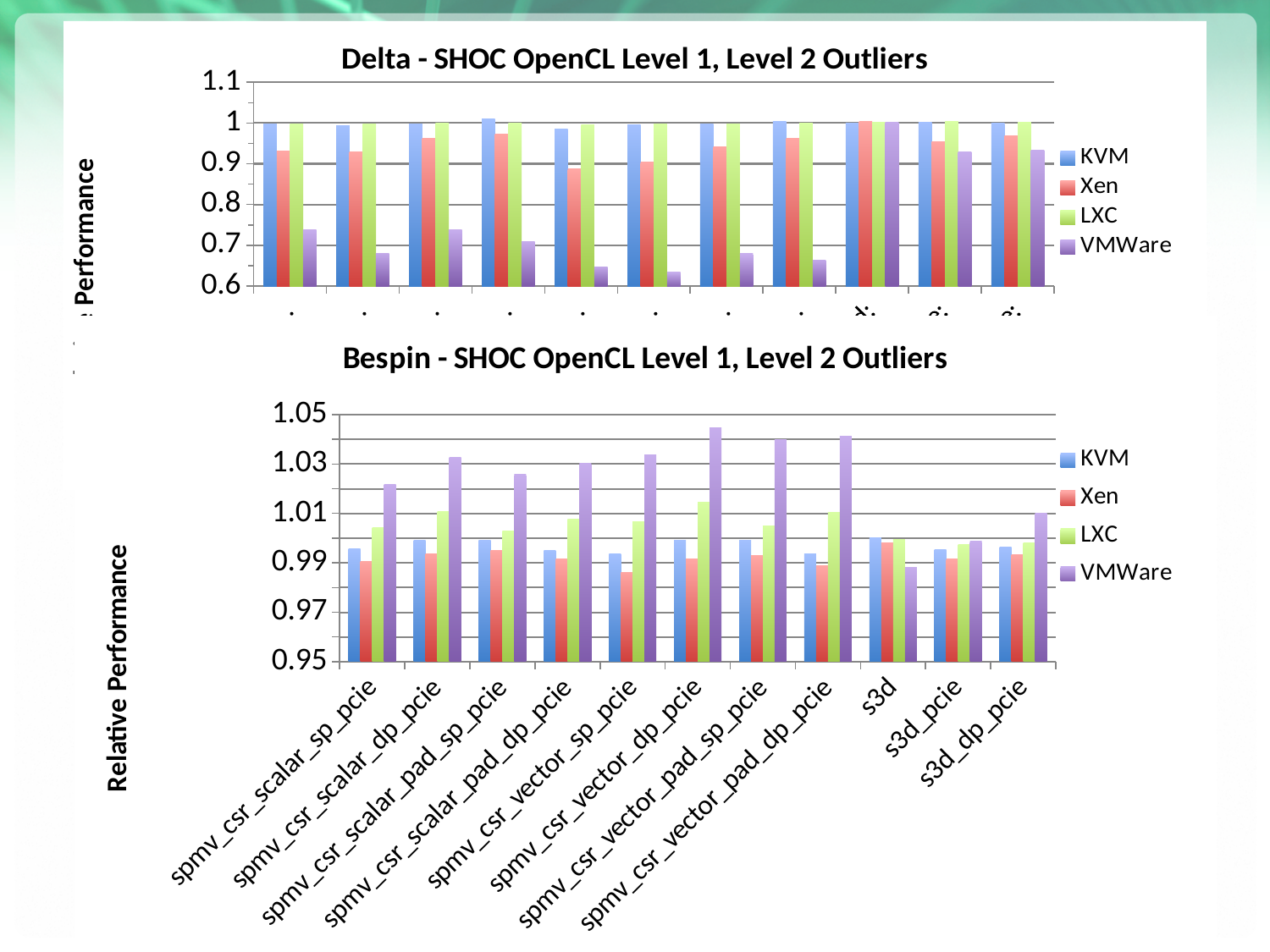
In the 'Bespin - SHOC OpenCL Level 1, Level 2 Outliers' chart, is the VMWare value for spmv_csr_vector_pad_sp_pcie greater or less than 1.03? greater What type of chart is the 'Bespin - SHOC OpenCL Level 1, Level 2 Outliers' chart? bar chart In the 'Bespin - SHOC OpenCL Level 1, Level 2 Outliers' chart, which series has the highest value for spmv_csr_vector_pad_sp_pcie? VMWare Which series is shown in green in the 'Bespin - SHOC OpenCL Level 1, Level 2 Outliers' chart? LXC In the 'Delta - SHOC OpenCL Level 1, Level 2 Outliers' chart, which series has the lowest value in the leftmost category? VMWare In the 'Bespin - SHOC OpenCL Level 1, Level 2 Outliers' chart, which is larger for spmv_csr_scalar_dp_pcie, the KVM value or the VMWare value? VMWare How many series does the legend of the 'Delta - SHOC OpenCL Level 1, Level 2 Outliers' chart list? 4 In the 'Bespin - SHOC OpenCL Level 1, Level 2 Outliers' chart, which series has the lowest value for s3d? VMWare In the 'Bespin - SHOC OpenCL Level 1, Level 2 Outliers' chart, is the VMWare value for spmv_csr_scalar_sp_pcie greater or less than 1.01? greater In the 'Bespin - SHOC OpenCL Level 1, Level 2 Outliers' chart, how many categories are shown on the x axis? 11 What is the y-axis label of the 'Bespin - SHOC OpenCL Level 1, Level 2 Outliers' chart? Relative Performance In the 'Delta - SHOC OpenCL Level 1, Level 2 Outliers' chart, is the VMWare value for the leftmost category greater or less than 0.8? less